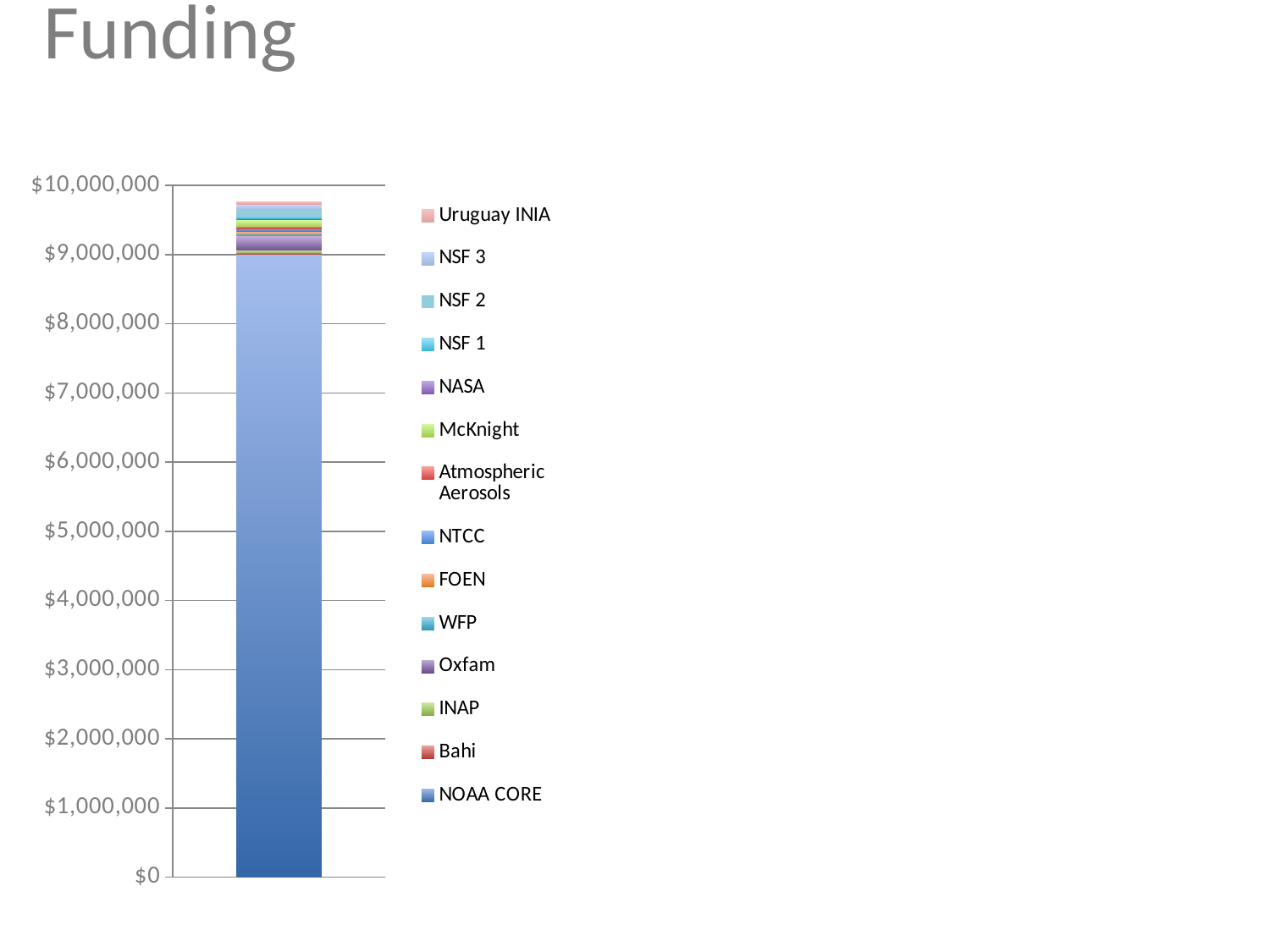
What is the title of the slide containing the chart? Funding Is the total height of the stacked bar greater or less than $10,000,000? less How many series does the legend list? 14 What is the highest value shown on the vertical axis? $10,000,000 What kind of chart is shown on the slide? stacked bar chart Which is larger, the NOAA CORE segment or the NSF 3 segment? NOAA CORE Is the value for NOAA CORE greater or less than $8,000,000? greater Which series accounts for the largest segment of the bar? NOAA CORE Is the total height of the stacked bar greater or less than $9,000,000? greater How many bars are plotted in the chart? 1